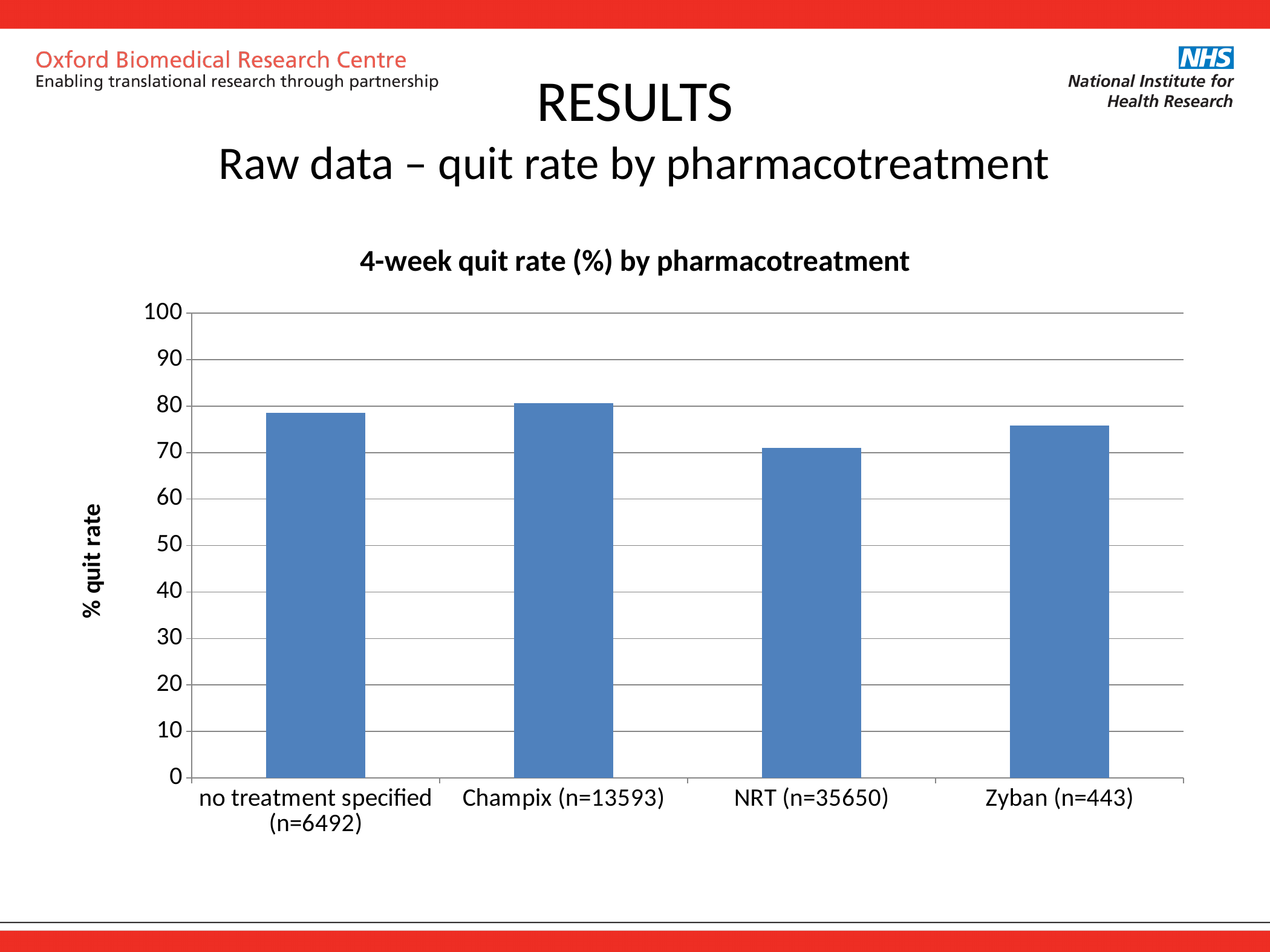
What kind of chart is shown on the slide? bar chart How many pharmacotreatment categories are shown on the x axis? 4 Is the 4-week quit rate for no treatment specified (n=6492) greater or less than 70? greater Is the 4-week quit rate for Zyban (n=443) greater or less than 80? less Which pharmacotreatment has the lowest 4-week quit rate? NRT (n=35650) Is the 4-week quit rate for Champix (n=13593) greater or less than 70? greater Which has a higher 4-week quit rate, Champix (n=13593) or NRT (n=35650)? Champix (n=13593) What is the label on the y axis of the chart? % quit rate Which has a higher 4-week quit rate, Zyban (n=443) or NRT (n=35650)? Zyban (n=443) What is the title of the chart? 4-week quit rate (%) by pharmacotreatment Which pharmacotreatment has the highest 4-week quit rate? Champix (n=13593)